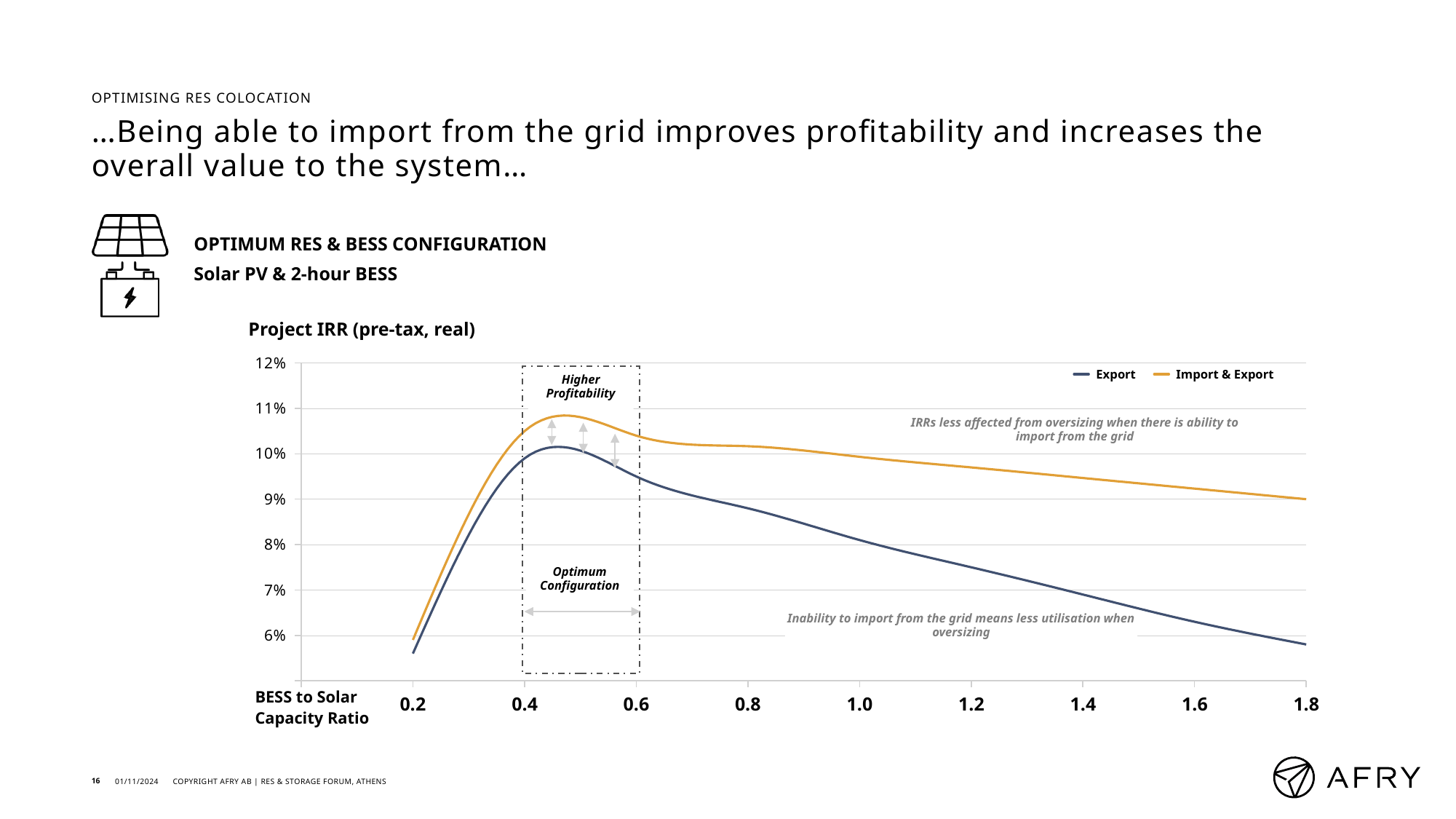
What is the label of the x axis of the chart? BESS to Solar Capacity Ratio Does the Export series rise or fall as the BESS to Solar Capacity Ratio increases from 0.6 to 1.8? fall How many series does the chart legend list? 2 At a BESS to Solar Capacity Ratio of 1.8, which series has the higher Project IRR, Export or Import & Export? Import & Export Is the value of the Import & Export series at a BESS to Solar Capacity Ratio of 1.4 greater or less than 9%? greater Is the value of the Export series at a BESS to Solar Capacity Ratio of 1.0 greater or less than 9%? less Is the peak value of the Import & Export series greater or less than 10%? greater What is the title of the chart? Project IRR (pre-tax, real) What kind of chart is shown on the slide? line chart